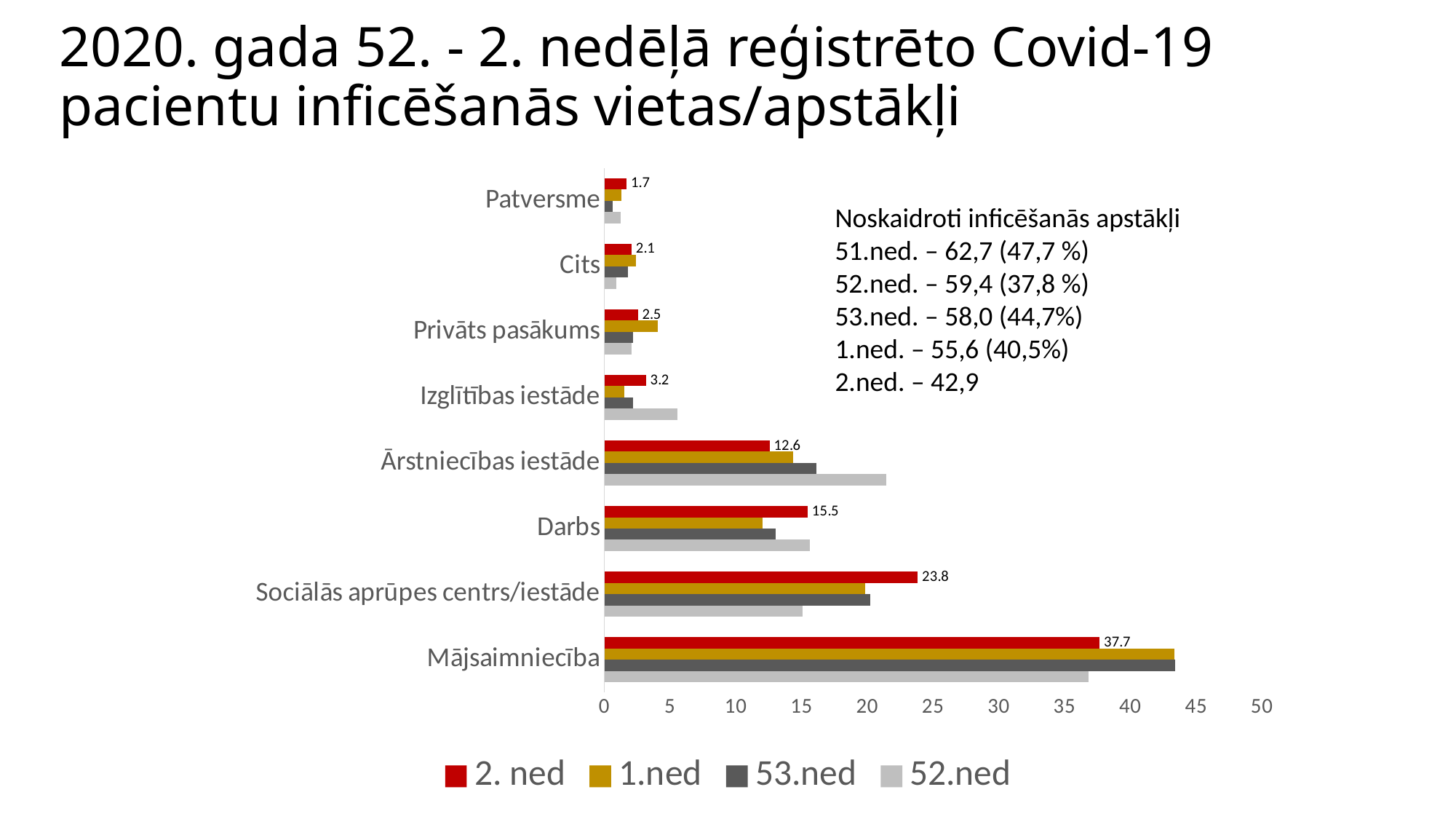
What is the value for Sociālās aprūpes centrs/iestāde in the 2. ned series? 23.8 What is the value for Patversme in the 2. ned series? 1.7 Which category has the lowest value in the 2. ned series? Patversme How many categories are shown on the chart? 8 In the 2. ned series, what is the difference between Mājsaimniecība and Sociālās aprūpes centrs/iestāde? 13.9 What is the value for Darbs in the 2. ned series? 15.5 Is the value for Mājsaimniecība in the 52.ned series greater or less than 40? less In the 2. ned series, which is larger: Darbs or Ārstniecības iestāde? Darbs How many series does the legend list? 4 Which category has the highest value in the 2. ned series? Mājsaimniecība Is the value for Mājsaimniecība in the 1.ned series greater or less than 40? greater What is the value for Mājsaimniecība in the 2. ned series? 37.7